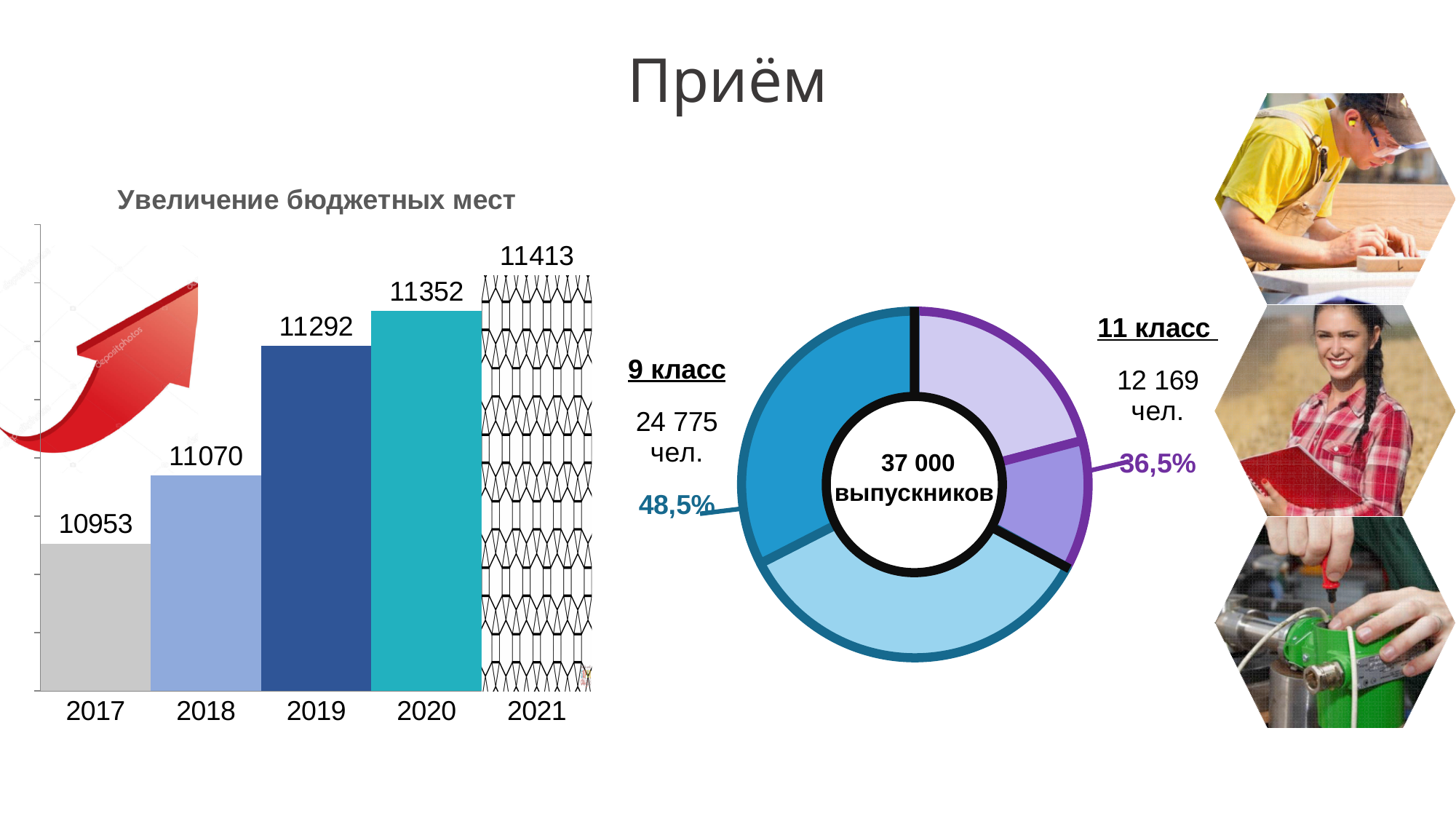
In the bar chart 'Увеличение бюджетных мест', which year has the lowest value? 2017 In the bar chart 'Увеличение бюджетных мест', what is the difference between the values for 2020 and 2019? 60 In the bar chart 'Увеличение бюджетных мест', what is the value for 2017? 10953 In the bar chart 'Увеличение бюджетных мест', do the values rise or fall from 2017 to 2021? rise How many years are shown on the x axis of the bar chart 'Увеличение бюджетных мест'? 5 In the bar chart 'Увеличение бюджетных мест', which year has the highest value? 2021 What kind of chart is 'Увеличение бюджетных мест'? bar chart In the bar chart 'Увеличение бюджетных мест', what is the difference between the values for 2021 and 2017? 460 In the bar chart 'Увеличение бюджетных мест', which is larger, the value for 2018 or the value for 2019? 2019 In the donut chart on the right, what share of graduates is labelled for '9 класс'? 48,5% In the bar chart 'Увеличение бюджетных мест', what is the value for 2020? 11352 In the donut chart on the right, how many people are labelled for '11 класс'? 12 169 чел.